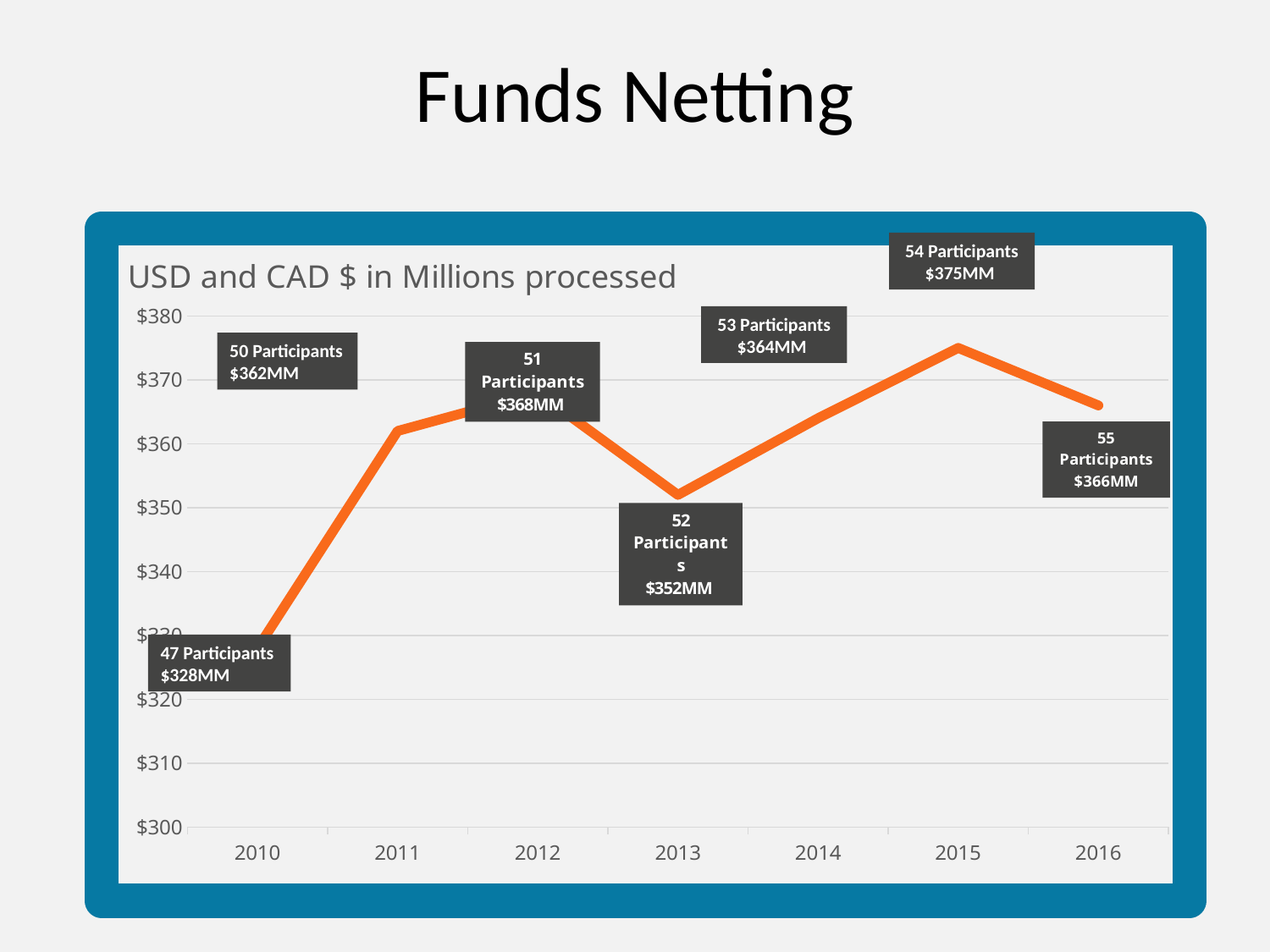
Which year has the lowest value? 2010 How many years are plotted on the x axis? 7 What kind of chart is shown? line chart What is the title of the chart? USD and CAD $ in Millions processed Does the value rise or fall from 2012 to 2013? fall How many participants are shown for 2013? 52 What is the difference between the 2015 value and the 2010 value? $47MM What value is shown for 2010? $328MM Which year has the highest value? 2015 Which is larger, the value for 2012 or the value for 2016? 2012 What value is shown for 2015? $375MM Is the value for 2013 greater or less than $360? less